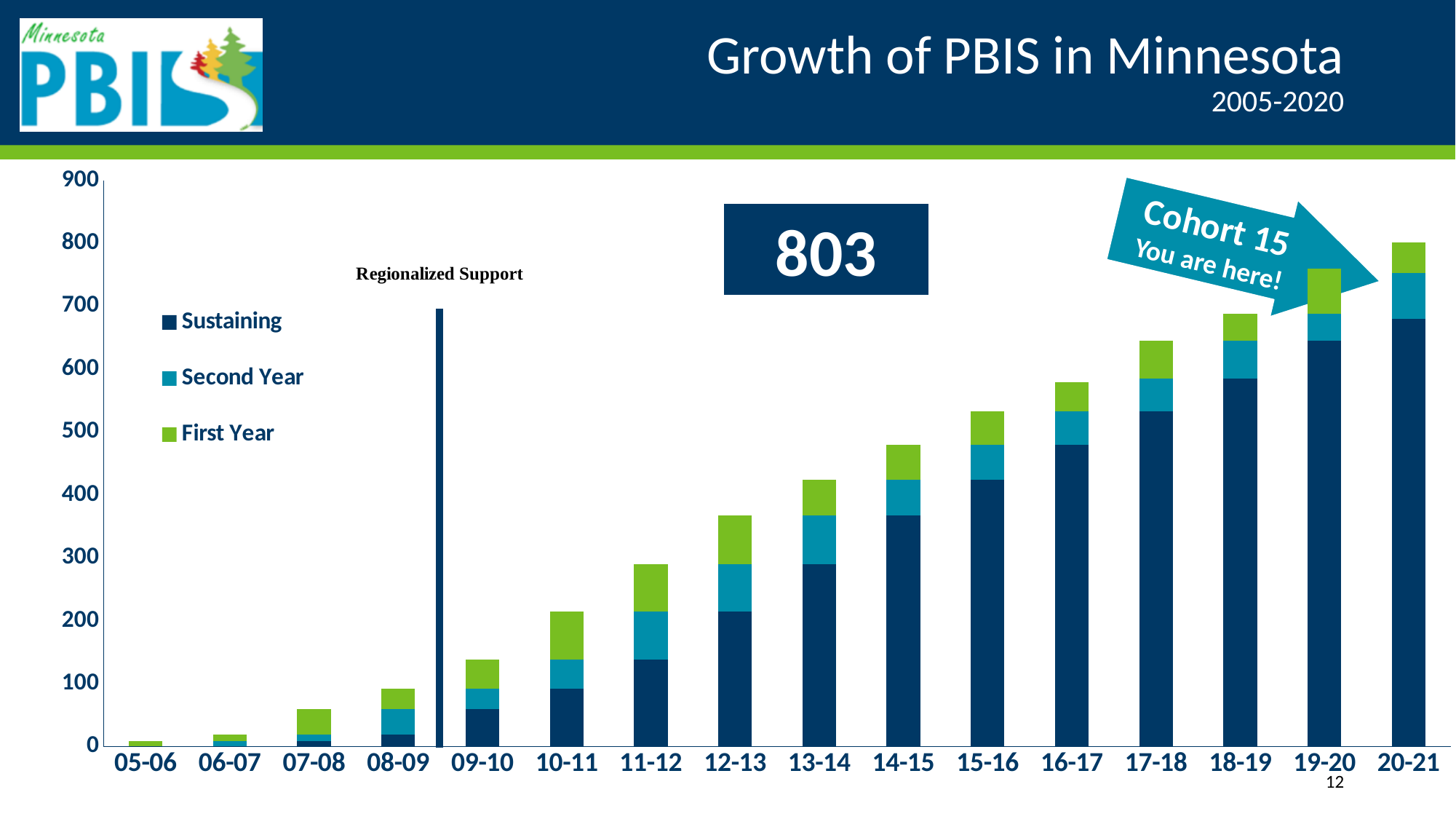
Which school year has the tallest stacked bar? 20-21 What are the three series named in the legend? Sustaining, Second Year, First Year Is the total bar height for 09-10 greater or less than 200? less What number is displayed in the dark box above the bars? 803 Which has the taller stacked bar, 18-19 or 14-15? 18-19 Which school year has the shortest stacked bar? 05-06 Is the total bar height for 20-21 greater or less than 700? greater What kind of chart is shown on the slide? bar chart Is the total bar height for 12-13 greater or less than 400? less Do the total bar heights rise or fall from 05-06 to 20-21? rise How many school-year categories are shown on the x axis? 16 How many series does the legend list? 3